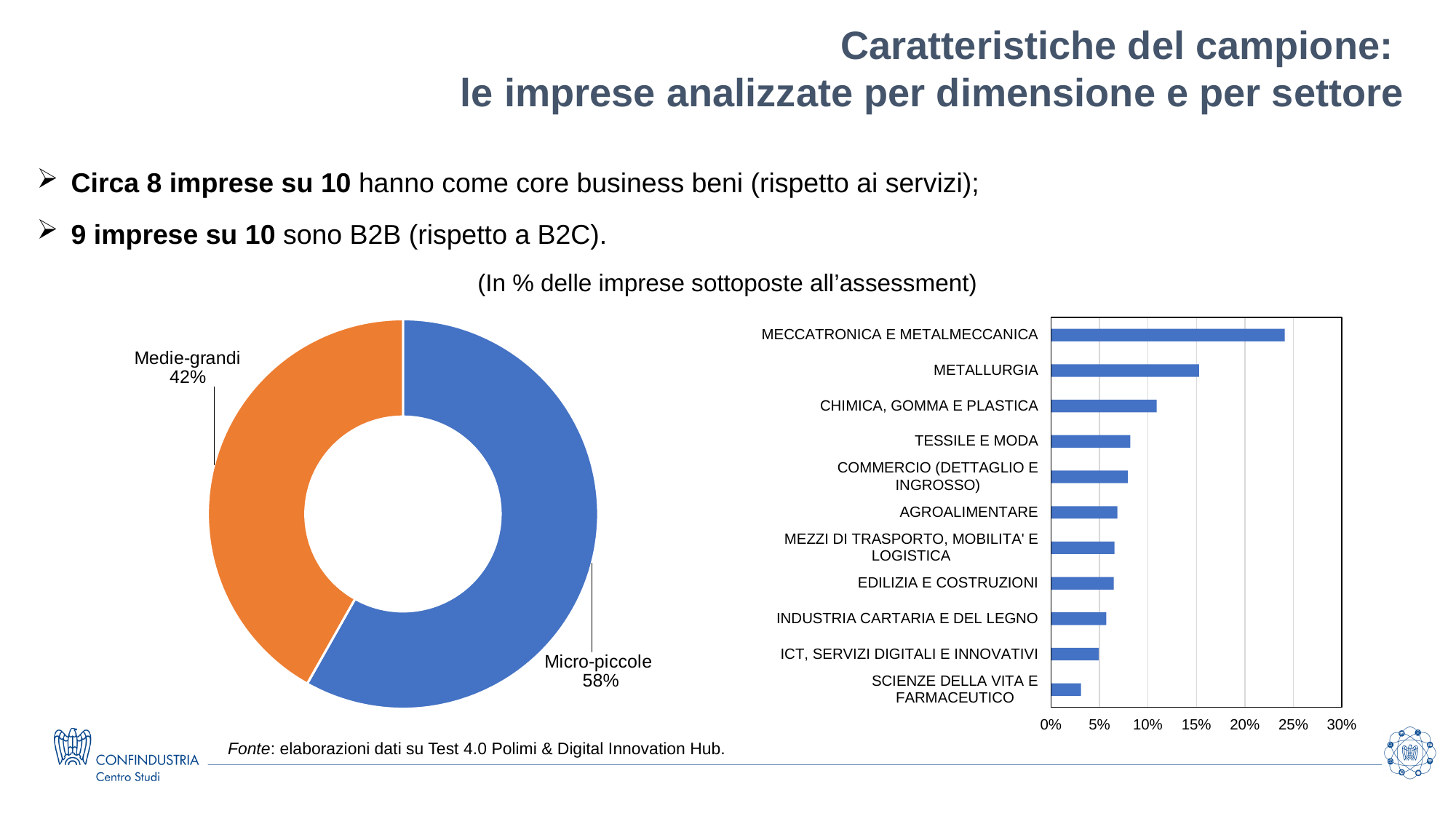
How many sectors are shown in the bar chart on the right? 11 In the bar chart on the right, which sector has the lowest share of firms? SCIENZE DELLA VITA E FARMACEUTICO In the donut chart on the left, what share of firms are Micro-piccole? 58% In the donut chart on the left, which segment is larger, Micro-piccole or Medie-grandi? Micro-piccole In the bar chart on the right, which sector has the highest share of firms? MECCATRONICA E METALMECCANICA In the donut chart on the left, what share of firms are Medie-grandi? 42% In the bar chart on the right, which sector has a larger share, METALLURGIA or TESSILE E MODA? METALLURGIA What kind of chart is shown on the right side of the slide? Bar chart In the bar chart on the right, is the value for MECCATRONICA E METALMECCANICA greater or less than 20%? greater In the donut chart on the left, what is the difference in percentage points between Micro-piccole and Medie-grandi? 16 percentage points In the bar chart on the right, is the value for SCIENZE DELLA VITA E FARMACEUTICO greater or less than 5%? less In the bar chart on the right, is the value for METALLURGIA greater or less than 10%? greater